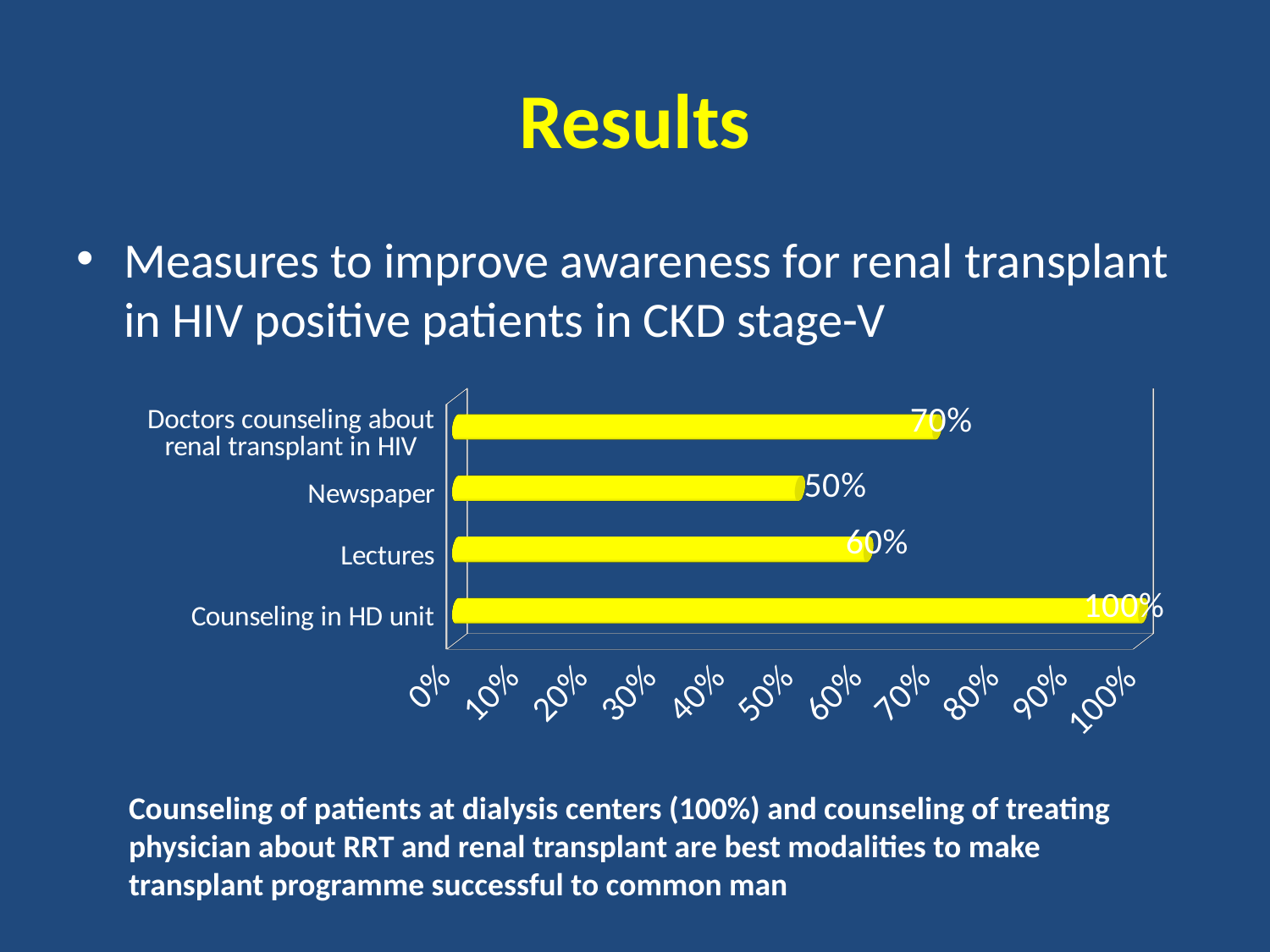
What is the value for Lectures? 60% What is the value for Doctors counseling about renal transplant in HIV? 70% What kind of chart is shown on the slide? bar chart What is the value for Newspaper? 50% What is the difference between the values for Doctors counseling about renal transplant in HIV and Lectures? 10% What is the difference between the values for Counseling in HD unit and Newspaper? 50% Which is larger, the value for Lectures or the value for Newspaper? Lectures Which category has the highest value? Counseling in HD unit How many categories are shown in the chart? 4 Is the value for Doctors counseling about renal transplant in HIV greater or less than 60%? greater What is the value for Counseling in HD unit? 100% Which category has the lowest value? Newspaper